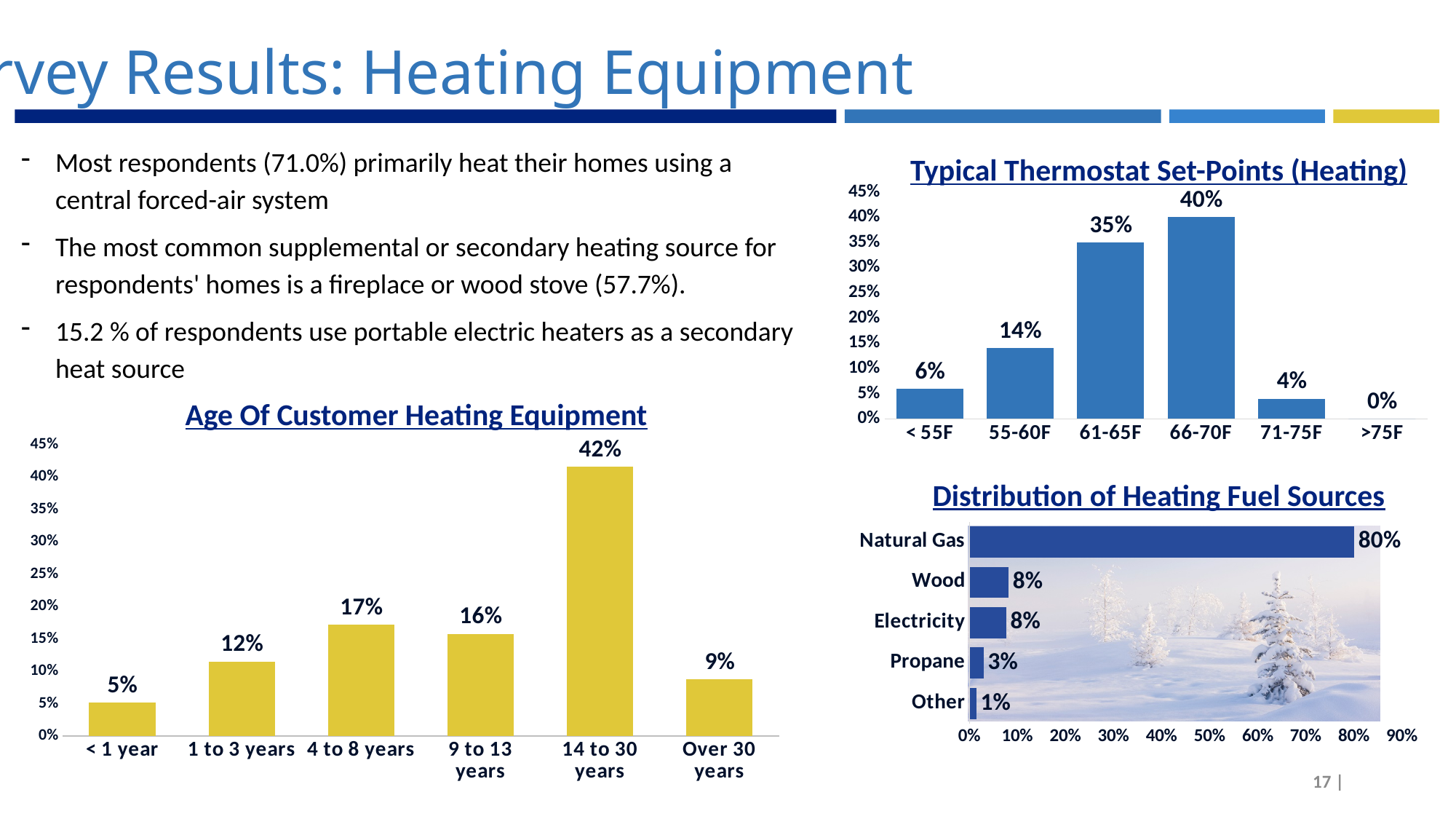
In the 'Age Of Customer Heating Equipment' chart, what is the difference between '4 to 8 years' and '9 to 13 years'? 1% In the 'Distribution of Heating Fuel Sources' chart, what is the difference between 'Natural Gas' and 'Wood'? 72% In the 'Age Of Customer Heating Equipment' chart, how many categories are shown? 6 In the 'Typical Thermostat Set-Points (Heating)' chart, which is larger: '55-60F' or '71-75F'? 55-60F In the 'Distribution of Heating Fuel Sources' chart, how many categories are shown? 5 What kind of chart is 'Distribution of Heating Fuel Sources'? Bar chart In the 'Typical Thermostat Set-Points (Heating)' chart, which category has the highest value? 66-70F In the 'Age Of Customer Heating Equipment' chart, which category has the lowest value? < 1 year In the 'Typical Thermostat Set-Points (Heating)' chart, what is the value for '>75F'? 0% In the 'Age Of Customer Heating Equipment' chart, what is the value for '14 to 30 years'? 42% In the 'Distribution of Heating Fuel Sources' chart, what is the value for 'Natural Gas'? 80% In the 'Typical Thermostat Set-Points (Heating)' chart, what is the value for '61-65F'? 35%